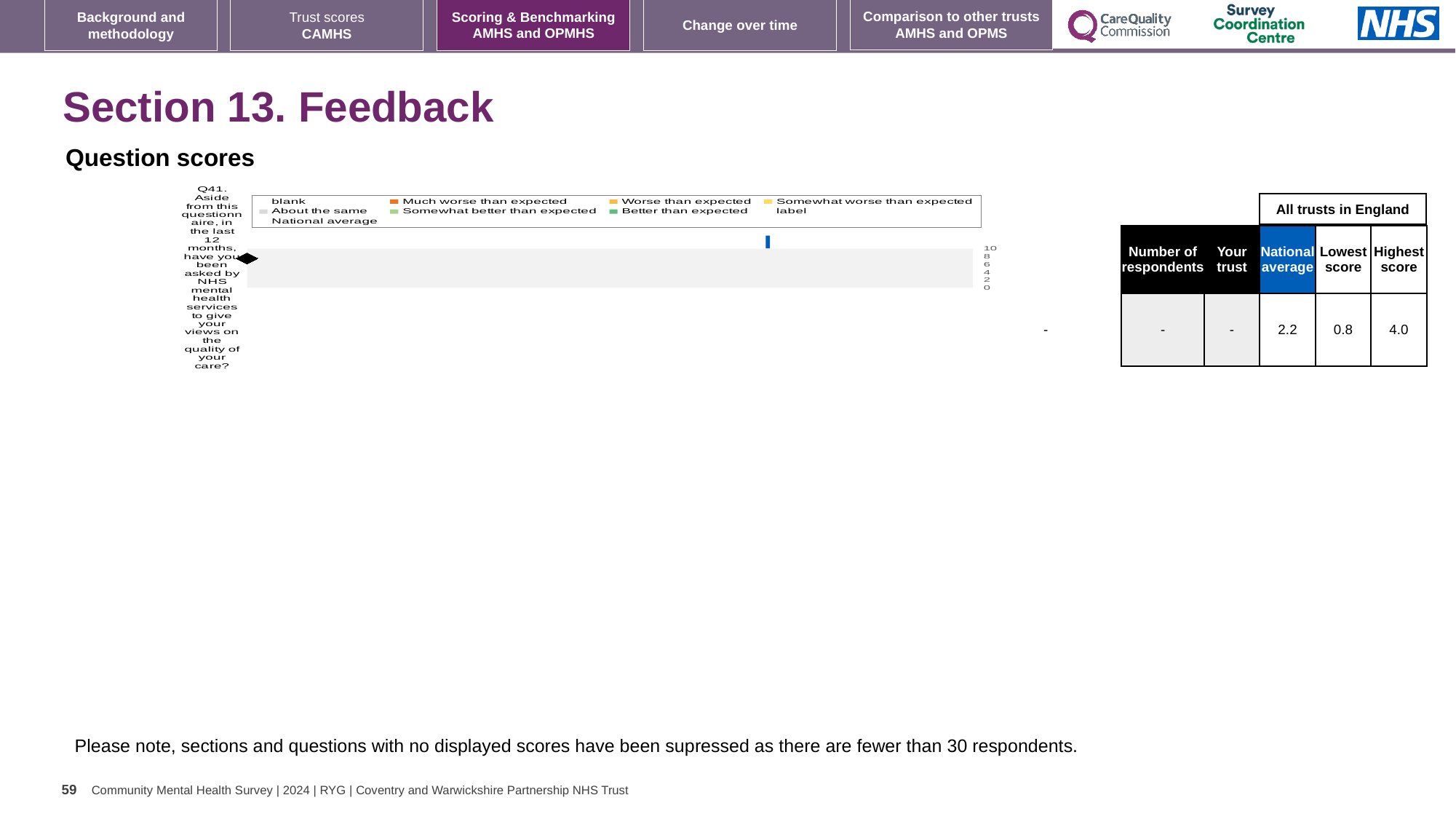
What is the highest value shown on the chart's axis? 10 In the table beside the chart, what is the difference between the Highest score and the Lowest score for Q41? 3.2 In the table beside the chart, what is the National average score for Q41? 2.2 In the table beside the chart, what is the Highest score among all trusts in England for Q41? 4.0 What kind of chart is shown under 'Question scores'? bar chart In the table beside the chart, which is larger for Q41: the National average or the Lowest score? National average How many question categories are plotted on the chart? 1 In the table beside the chart, what is the Lowest score among all trusts in England for Q41? 0.8 Which question is the single category on the chart? Q41